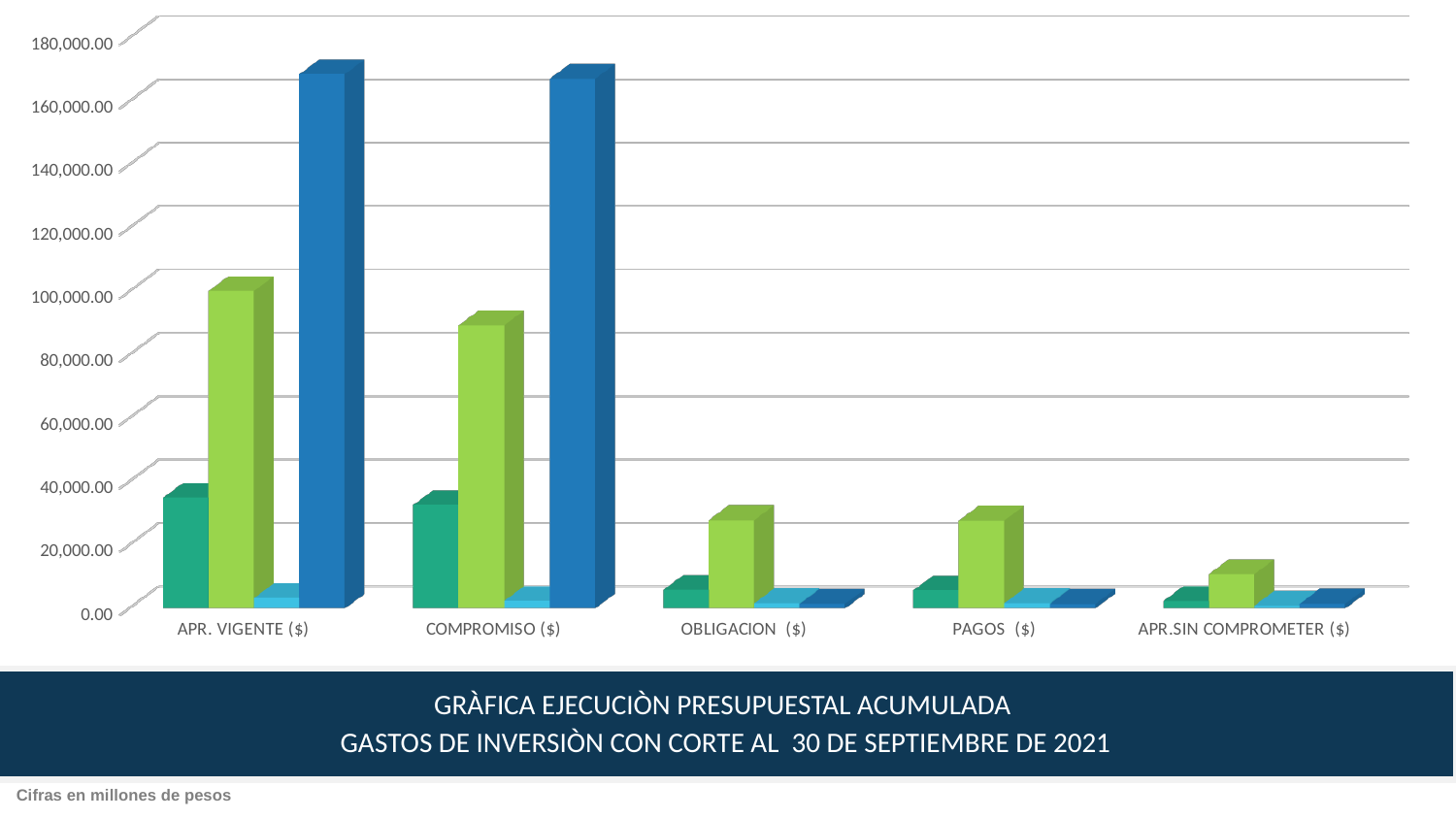
Is the value of the light green bar for APR.SIN COMPROMETER ($) greater or less than 20,000.00? less Is the value of the light green bar for COMPROMISO ($) greater or less than 100,000.00? less Which category has the shortest light green bar? APR.SIN COMPROMETER ($) According to the note below the chart, in what units are the figures expressed? millones de pesos Is the value of the dark blue bar for APR. VIGENTE ($) greater or less than 140,000.00? greater What kind of chart is shown on the slide? bar chart Which is larger: the light green bar for APR. VIGENTE ($) or the light green bar for COMPROMISO ($)? APR. VIGENTE ($) Which category has the tallest light green bar? APR. VIGENTE ($) How many categories are shown on the x axis of the chart? 5